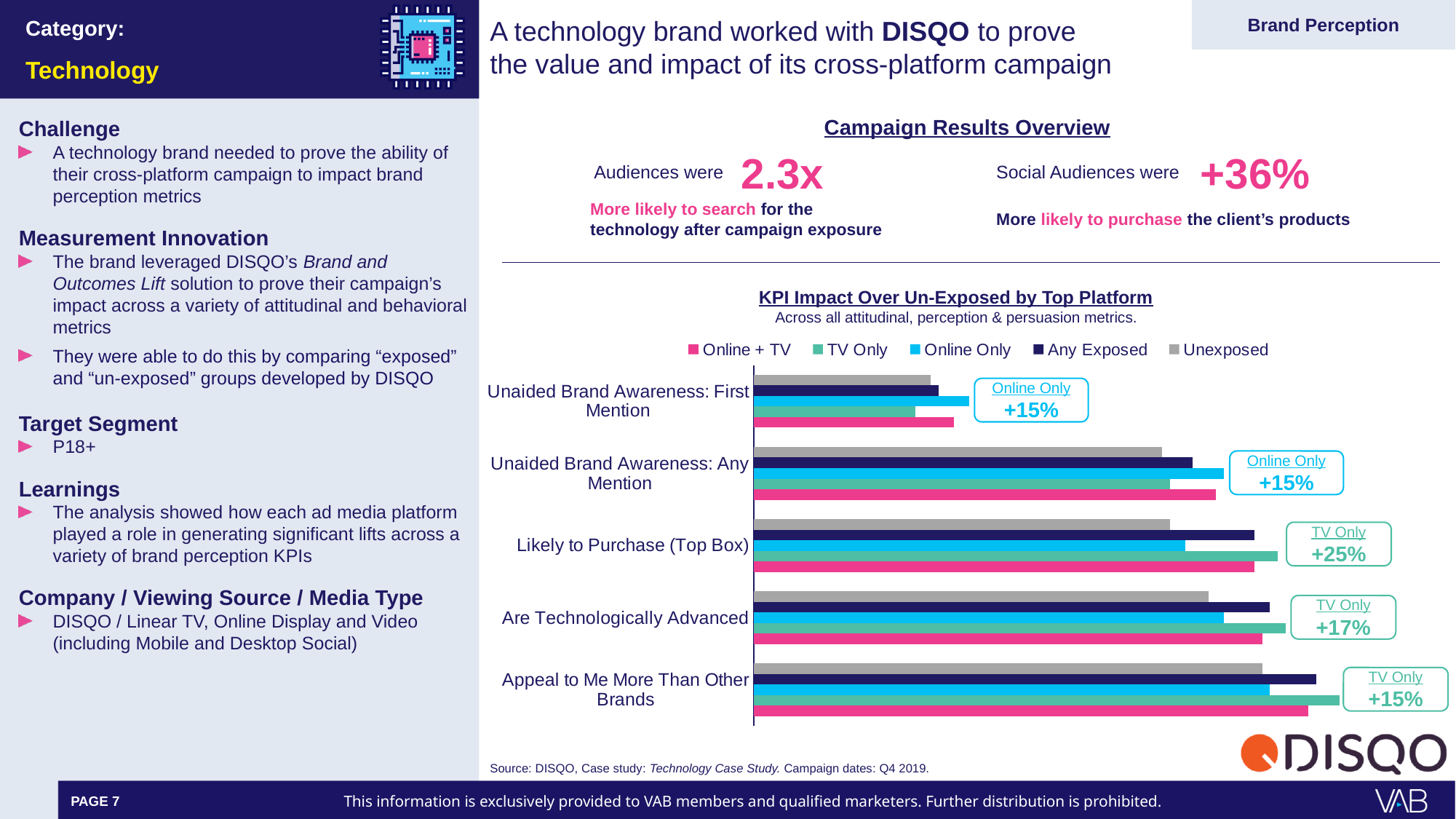
In the 'KPI Impact Over Un-Exposed by Top Platform' chart, for 'Likely to Purchase (Top Box)', which bar is longer: TV Only or Online Only? TV Only How many KPI categories are plotted in the 'KPI Impact Over Un-Exposed by Top Platform' chart? 5 In the 'KPI Impact Over Un-Exposed by Top Platform' chart, which series is shown in pink? Online + TV In the 'KPI Impact Over Un-Exposed by Top Platform' chart, for 'Unaided Brand Awareness: First Mention', which bar is longer: Online Only or TV Only? Online Only What kind of chart is the 'KPI Impact Over Un-Exposed by Top Platform' chart? bar chart In the 'KPI Impact Over Un-Exposed by Top Platform' chart, for 'Appeal to Me More Than Other Brands', which bar is longer: Any Exposed or Unexposed? Any Exposed In the 'KPI Impact Over Un-Exposed by Top Platform' chart, what lift does the callout show for TV Only on 'Likely to Purchase (Top Box)'? +25% In the 'KPI Impact Over Un-Exposed by Top Platform' chart, which KPI has the highest lift value shown in its callout? Likely to Purchase (Top Box) In the 'KPI Impact Over Un-Exposed by Top Platform' chart, what lift does the callout show for Online Only on 'Unaided Brand Awareness: First Mention'? +15% What is the subtitle printed under the 'KPI Impact Over Un-Exposed by Top Platform' chart title? Across all attitudinal, perception & persuasion metrics. How many series does the legend of the 'KPI Impact Over Un-Exposed by Top Platform' chart list? 5 In the 'KPI Impact Over Un-Exposed by Top Platform' chart, what lift does the callout show for TV Only on 'Are Technologically Advanced'? +17%